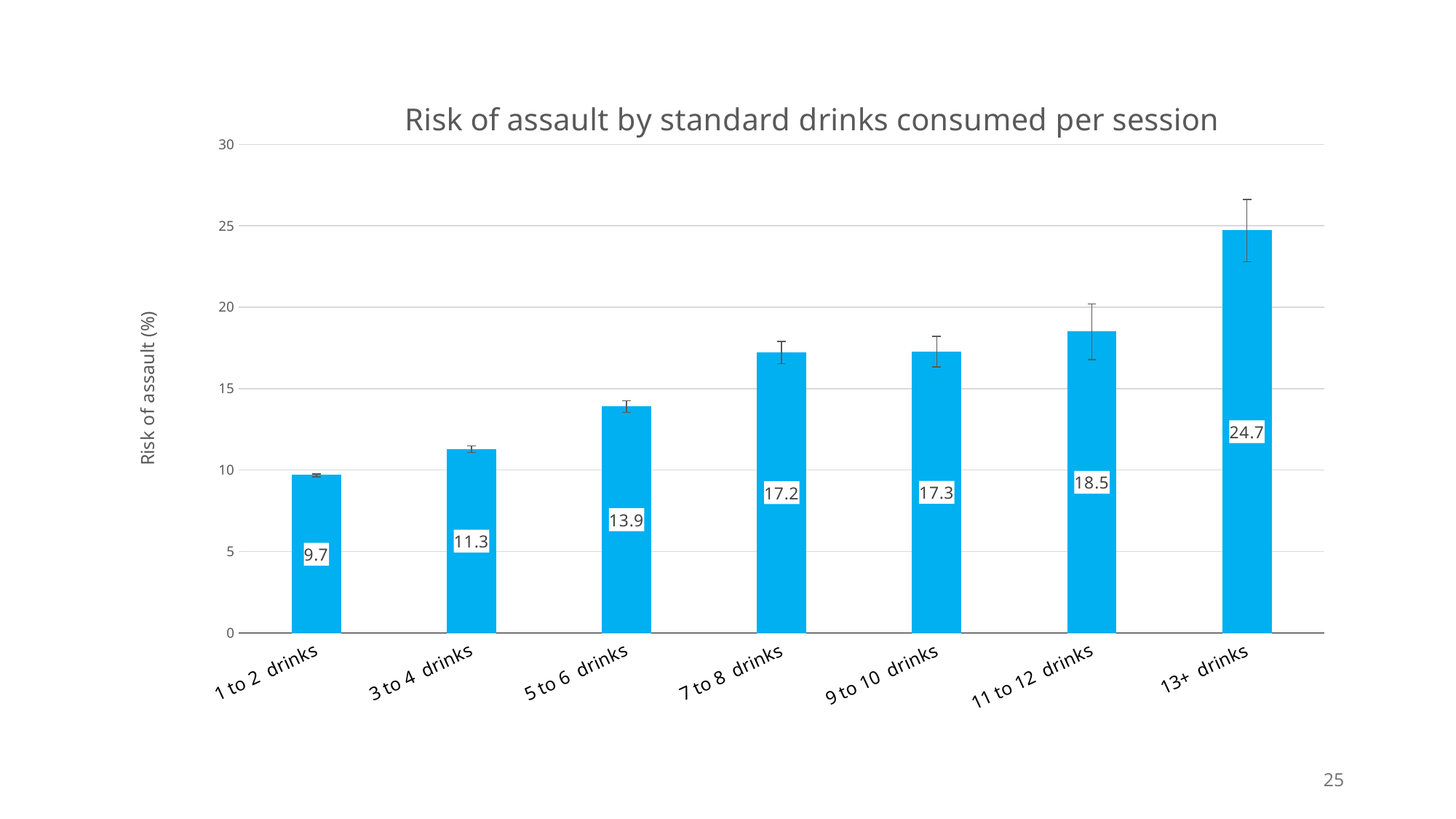
Which category has the highest risk of assault? 13+ drinks Which has a higher risk of assault: 11 to 12 drinks or 5 to 6 drinks? 11 to 12 drinks Does the risk of assault rise or fall as the number of drinks per session increases? rise How many drink categories are shown on the chart? 7 What is the difference in risk of assault between 5 to 6 drinks and 3 to 4 drinks? 2.6 What is the risk of assault for 7 to 8 drinks? 17.2 Is the value for 13+ drinks greater or less than 20? greater Which category has the lowest risk of assault? 1 to 2 drinks What is the risk of assault for 13+ drinks? 24.7 What kind of chart is shown on the slide? bar chart What is the risk of assault for 1 to 2 drinks? 9.7 What is the difference in risk of assault between 13+ drinks and 11 to 12 drinks? 6.2